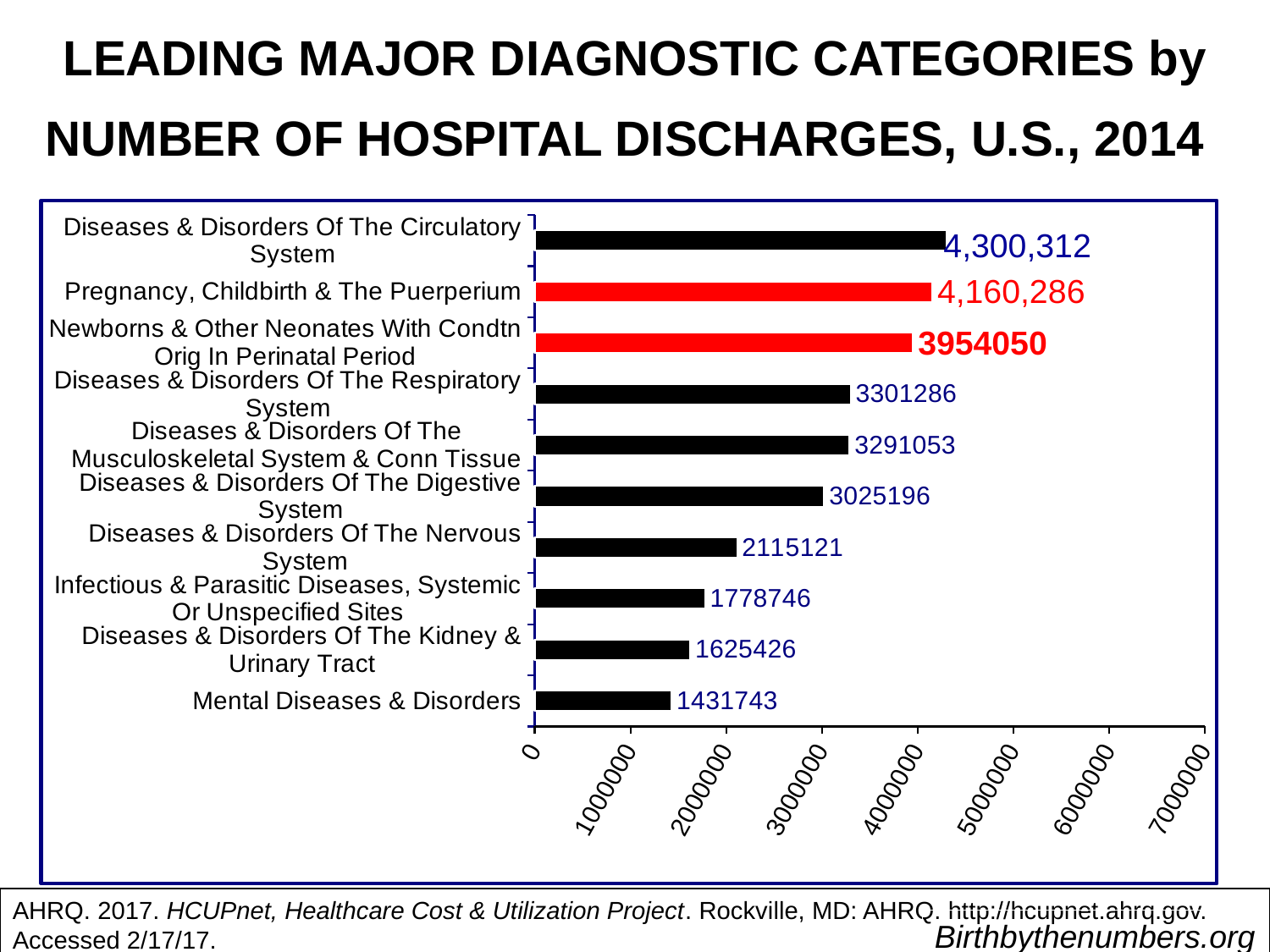
What is the number of hospital discharges for Diseases & Disorders Of The Circulatory System? 4,300,312 What value is shown for Mental Diseases & Disorders? 1431743 What kind of chart is shown on the slide? bar chart What is the difference in discharges between Diseases & Disorders Of The Nervous System and Infectious & Parasitic Diseases, Systemic Or Unspecified Sites? 336375 How many major diagnostic categories are plotted in the chart? 10 What is the difference in discharges between Diseases & Disorders Of The Circulatory System and Pregnancy, Childbirth & The Puerperium? 140,026 Which has more hospital discharges: Diseases & Disorders Of The Digestive System or Diseases & Disorders Of The Nervous System? Diseases & Disorders Of The Digestive System Is the value for Diseases & Disorders Of The Kidney & Urinary Tract greater or less than 2000000? less What is the number of hospital discharges for Pregnancy, Childbirth & The Puerperium? 4,160,286 Which major diagnostic category has the lowest number of hospital discharges? Mental Diseases & Disorders Which major diagnostic category has the highest number of hospital discharges? Diseases & Disorders Of The Circulatory System What value is shown for Newborns & Other Neonates With Condtn Orig In Perinatal Period? 3954050